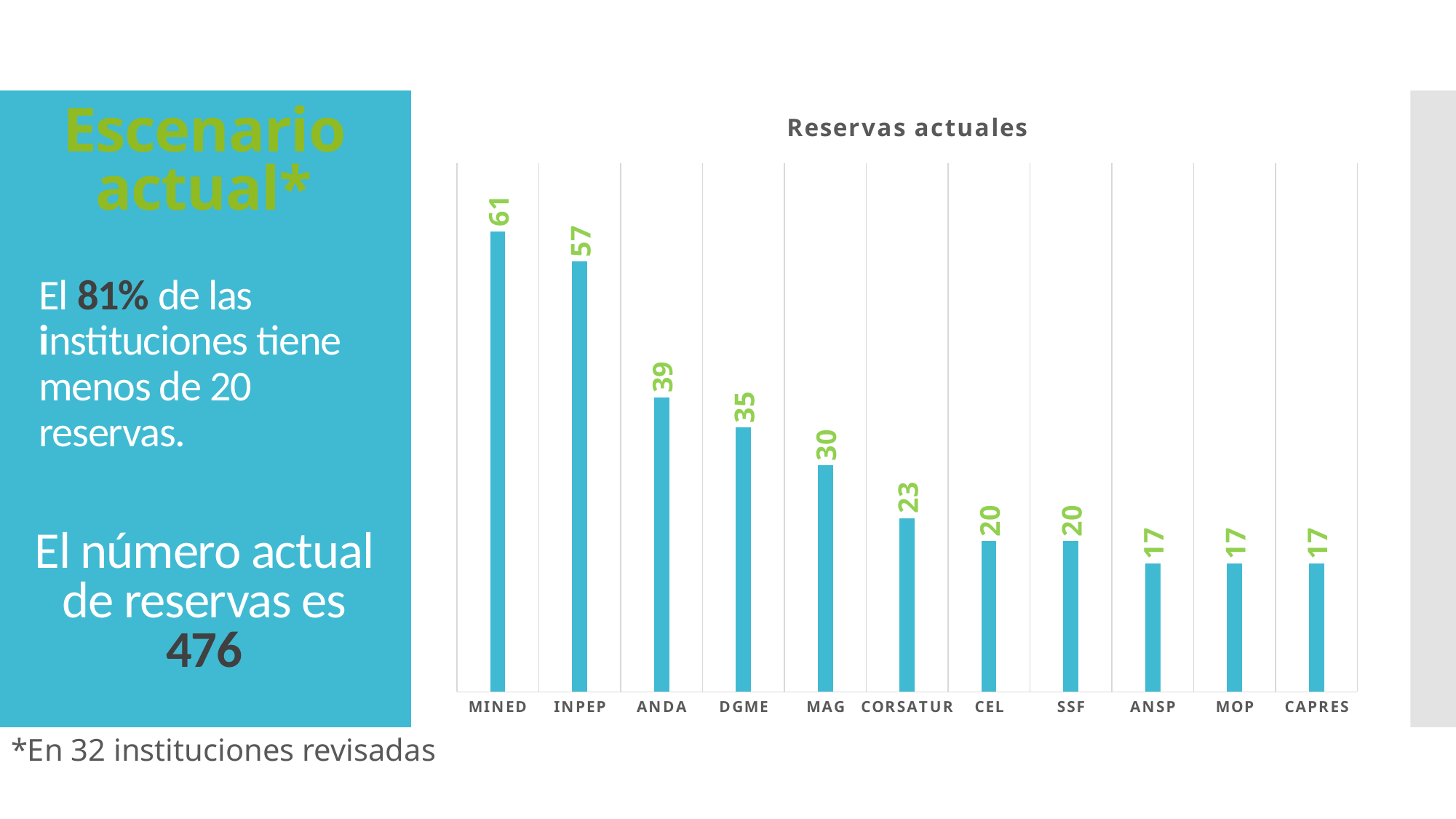
Do the values rise or fall from left to right across the categories? Fall What is the value for CORSATUR in the Reservas actuales chart? 23 What is the title of the chart? Reservas actuales What is the value for MINED in the Reservas actuales chart? 61 Which category has the highest value in the Reservas actuales chart? MINED How many categories are shown in the Reservas actuales chart? 11 How many categories have a value of 17? 3 Which is larger, the value for ANDA or the value for DGME? ANDA What is the difference between the values for DGME and MAG? 5 What kind of chart is shown on the slide? Bar chart What is the difference between the values for MINED and INPEP? 4 What is the value for ANDA in the Reservas actuales chart? 39